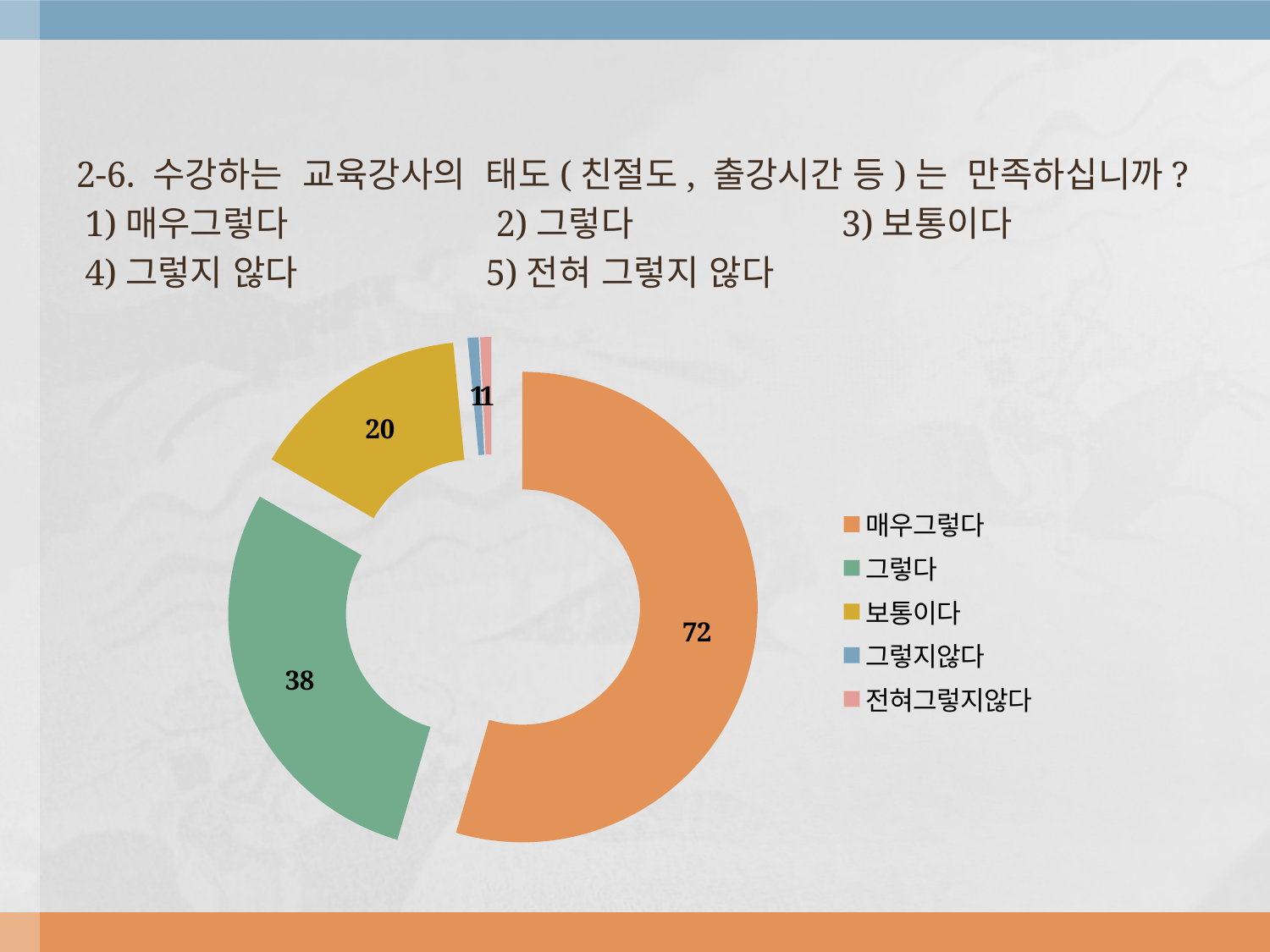
What kind of chart is shown on the slide? doughnut chart Which is larger, the value for 그렇다 or the value for 보통이다? 그렇다 What colour is the slice for 매우그렇다? orange How many categories does the legend list? 5 What is the difference between the values for 그렇다 and 보통이다? 18 What is the value for 보통이다? 20 What colour is the slice for 그렇다? green Which category has the highest value? 매우그렇다 What is the difference between the values for 매우그렇다 and 보통이다? 52 What is the value for 그렇다? 38 What is the difference between the values for 매우그렇다 and 그렇다? 34 What is the value for 매우그렇다? 72